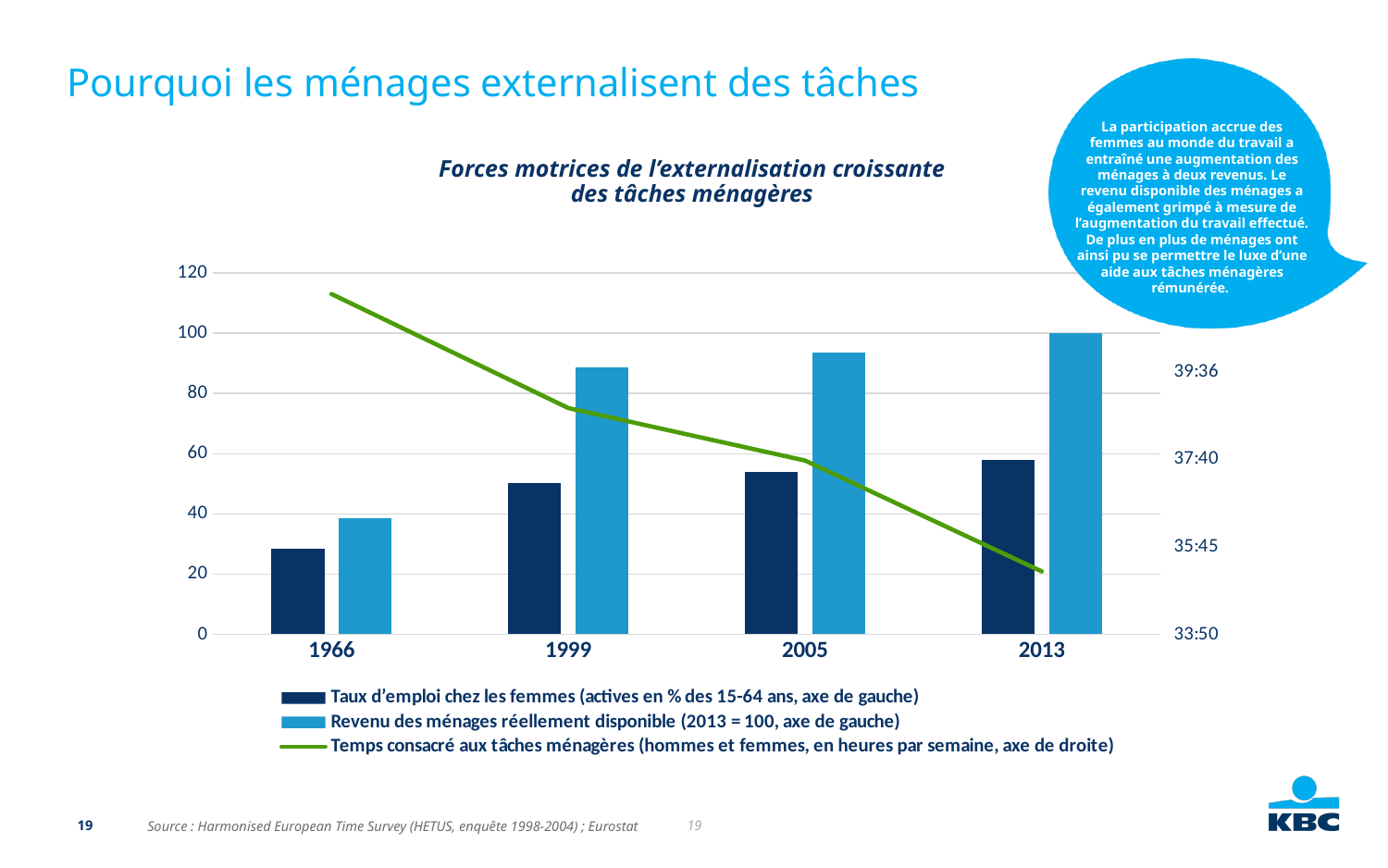
In 1966, which is larger: 'Taux d'emploi chez les femmes' or 'Revenu des ménages réellement disponible'? Revenu des ménages réellement disponible Is the value for 'Taux d'emploi chez les femmes' in 1966 greater or less than 40? less In which year is 'Taux d'emploi chez les femmes' lowest? 1966 How many series does the chart's legend list? 3 Does the line for 'Temps consacré aux tâches ménagères' rise or fall from 1966 to 2013? It falls How many years are shown on the x axis of the chart? 4 What is the title of the chart? Forces motrices de l'externalisation croissante des tâches ménagères What kind of chart is shown on the slide? A combined bar and line chart What is the value of 'Revenu des ménages réellement disponible' in 2013? 100 Is the value for 'Revenu des ménages réellement disponible' in 1999 greater or less than 80? greater In which year is 'Revenu des ménages réellement disponible' highest? 2013 Is the value for 'Taux d'emploi chez les femmes' in 2013 greater or less than 40? greater